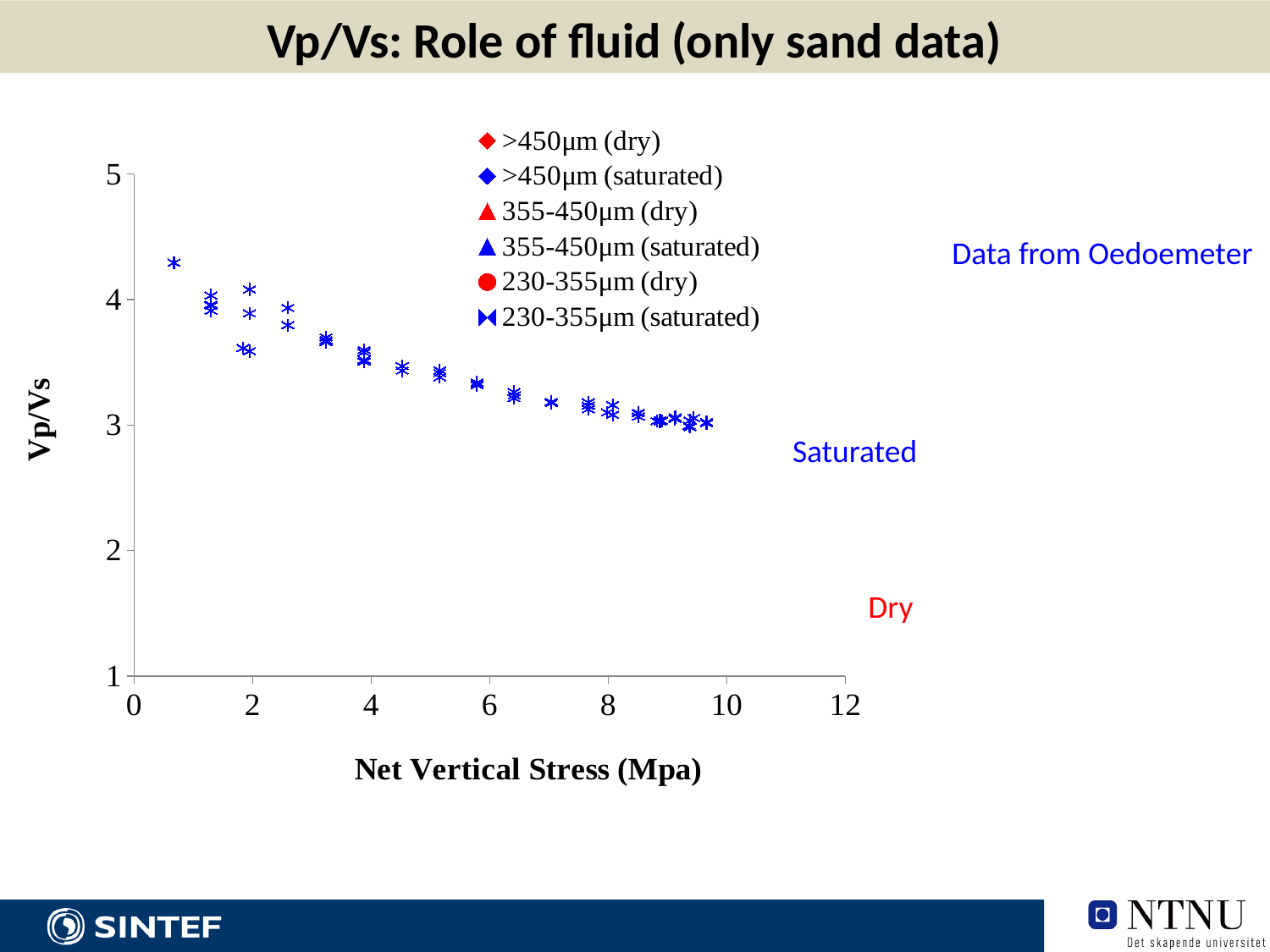
Do the plotted Vp/Vs values rise or fall as Net Vertical Stress increases? fall What is the title of the chart on the slide? Vp/Vs: Role of fluid (only sand data) How many series does the legend list? 6 Are the Vp/Vs values of the points plotted near 6 MPa greater or less than 4? less Is the Vp/Vs value of the plotted point at the lowest stress (near 0.7 MPa) greater or less than 4? greater Are the Vp/Vs values of the points plotted near 2 MPa greater or less than 3.5? greater What kind of chart is shown on the slide? scatter chart Which is larger: the Vp/Vs value of the point near 0.7 MPa or the Vp/Vs value of the points near 9 MPa? the point near 0.7 MPa What is the label of the x axis? Net Vertical Stress (Mpa)